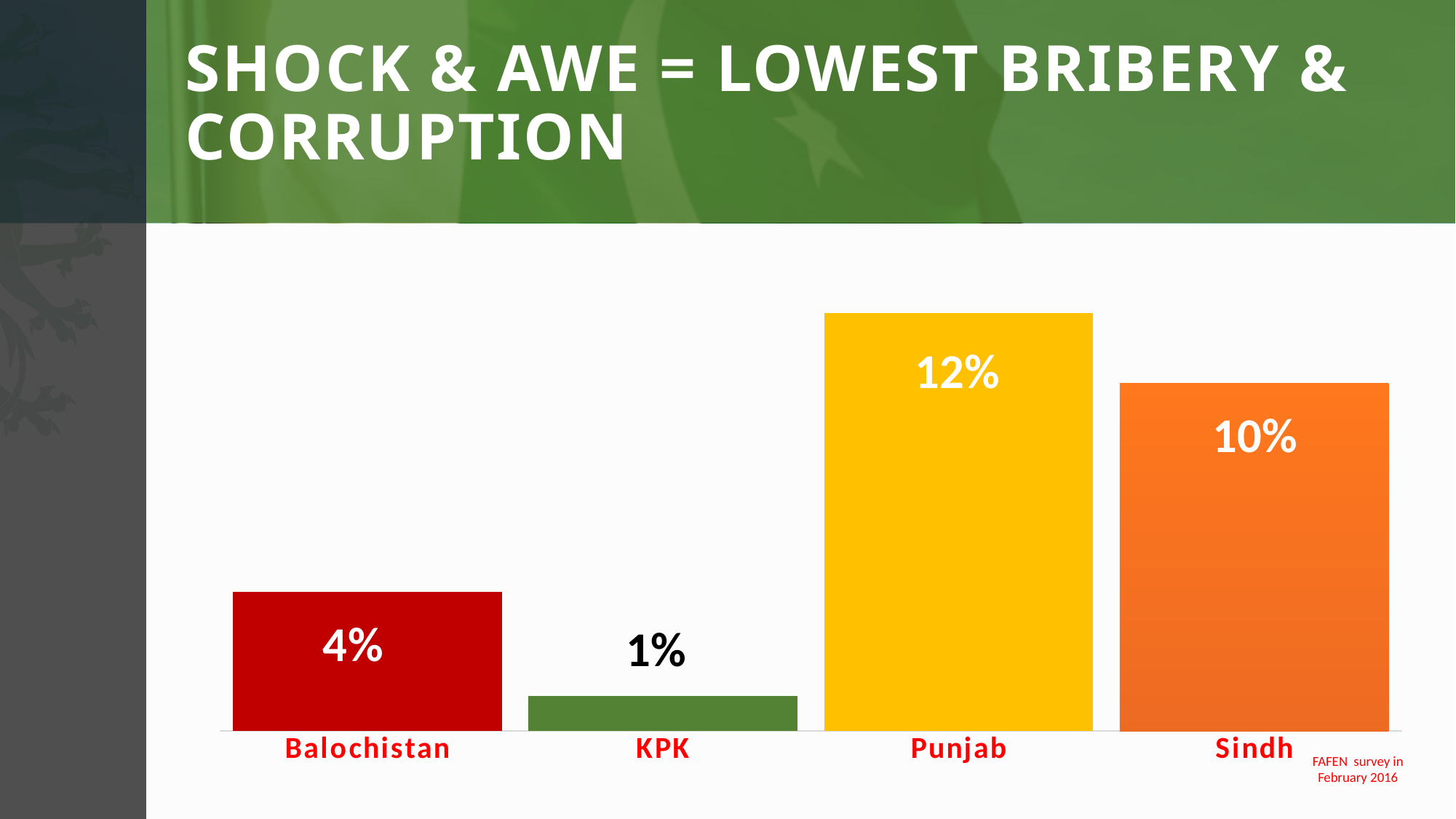
What is the value for Sindh? 10% Which province has the highest value? Punjab What is the value for KPK? 1% What kind of chart is shown on the slide? Bar chart What colour is the bar for KPK? Green What is the value for Balochistan? 4% Which province has the lowest value? KPK How many provinces are shown in the chart? 4 What is the difference between the values for Punjab and Sindh? 2% Which is larger, the value for Balochistan or the value for Sindh? Sindh What is the value for Punjab? 12% What is the difference between the values for Balochistan and KPK? 3%